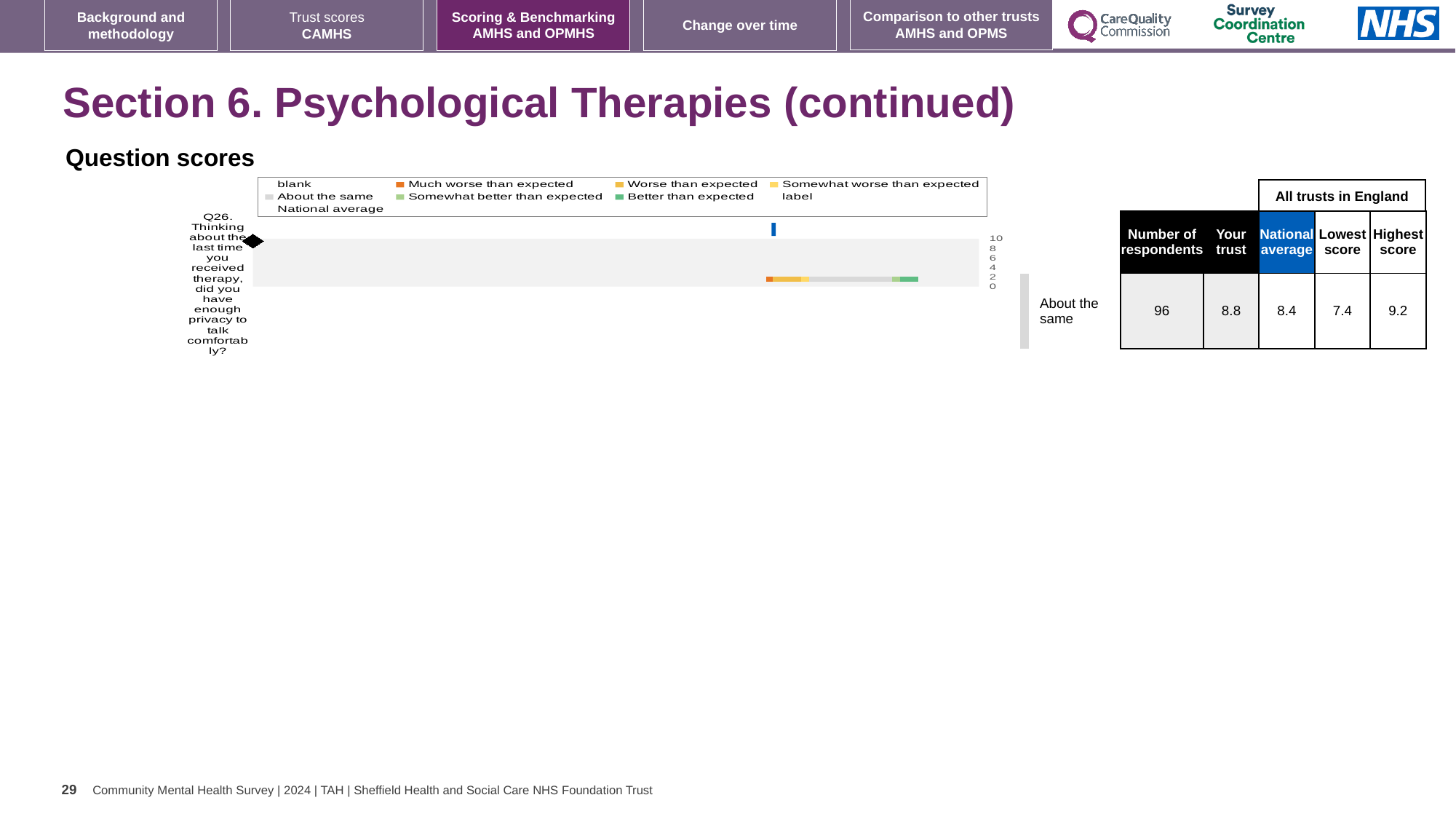
Which is larger for Q26, the 'Your trust' score or the national average? Your trust Which question is plotted in the Question scores chart? Q26. Thinking about the last time you received therapy, did you have enough privacy to talk comfortably? What benchmark category is shown next to the Q26 bar? About the same How many questions are plotted in the Question scores chart? 1 What kind of chart is shown under 'Question scores'? bar chart What is the national average score for Q26? 8.4 What is the difference between the 'Your trust' score and the national average for Q26? 0.4 How many respondents answered Q26? 96 What is the lowest score among all trusts in England for Q26? 7.4 What is the 'Your trust' score for Q26? 8.8 What is the highest score among all trusts in England for Q26? 9.2 What is the difference between the highest and lowest scores for Q26? 1.8